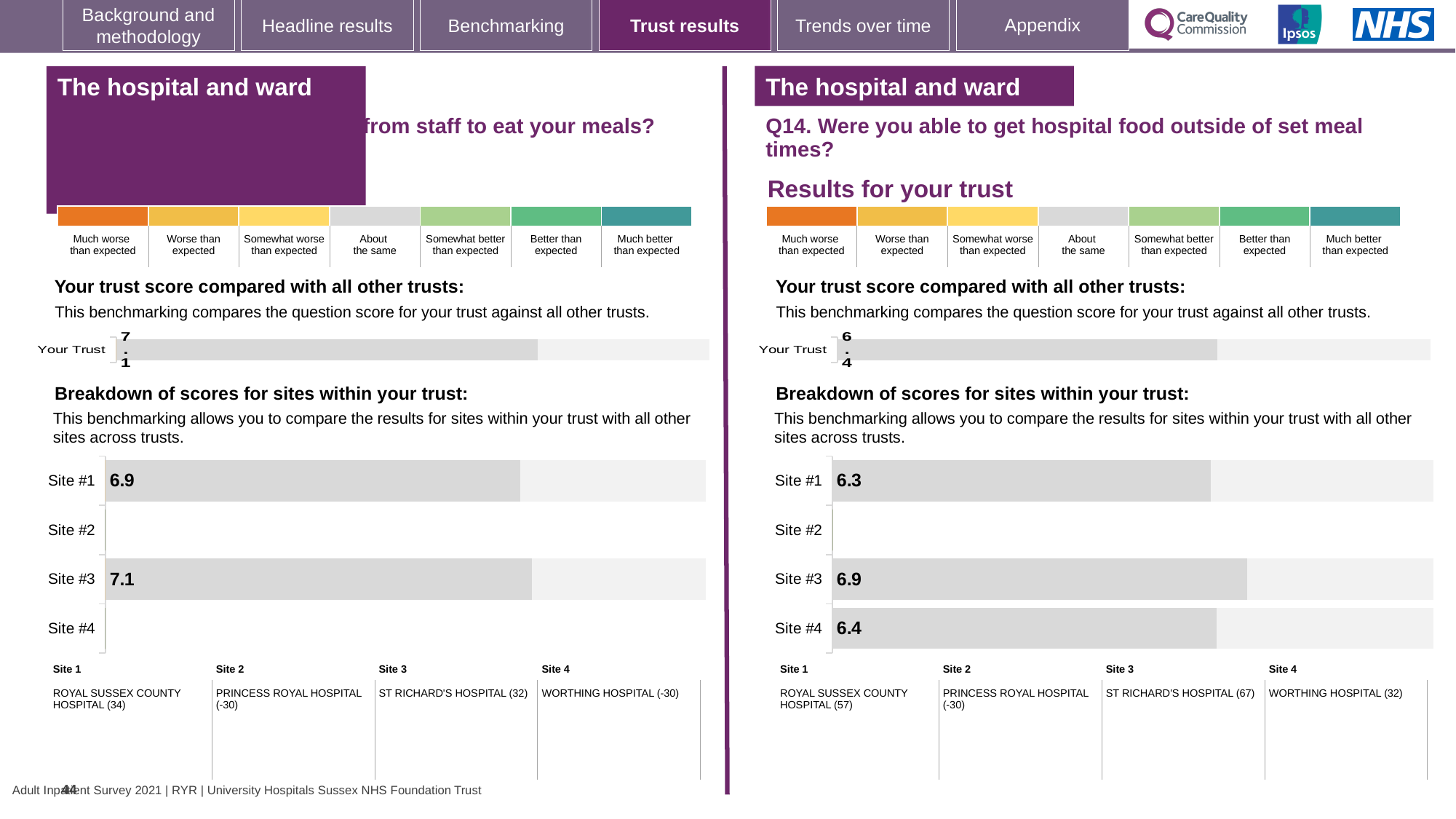
What type of chart is used for the site breakdown on the right-hand side of the slide? Bar chart In the right-hand site breakdown chart for Q14, what is the difference between the scores for Site #3 and Site #1? 0.6 In the left-hand site breakdown chart, what is the score for Site #3? 7.1 In the right-hand chart for Q14, what is the score for Site #4? 6.4 In the right-hand 'Your trust score compared with all other trusts' chart for Q14, what is the score for Your Trust? 6.4 In the right-hand site breakdown chart for Q14, which site has the highest score? Site #3 In the right-hand chart for Q14 (hospital food outside of set meal times), what is the score for Site #1? 6.3 In the left-hand site breakdown chart, which has the higher score, Site #1 or Site #3? Site #3 In the left-hand site breakdown chart, what is the difference between the scores for Site #3 and Site #1? 0.2 In the left-hand site breakdown chart, what is the score for Site #1? 6.9 In the left-hand 'Your trust score compared with all other trusts' chart, what is the score for Your Trust? 7.1 In the right-hand chart for Q14, what is the score for Site #3? 6.9